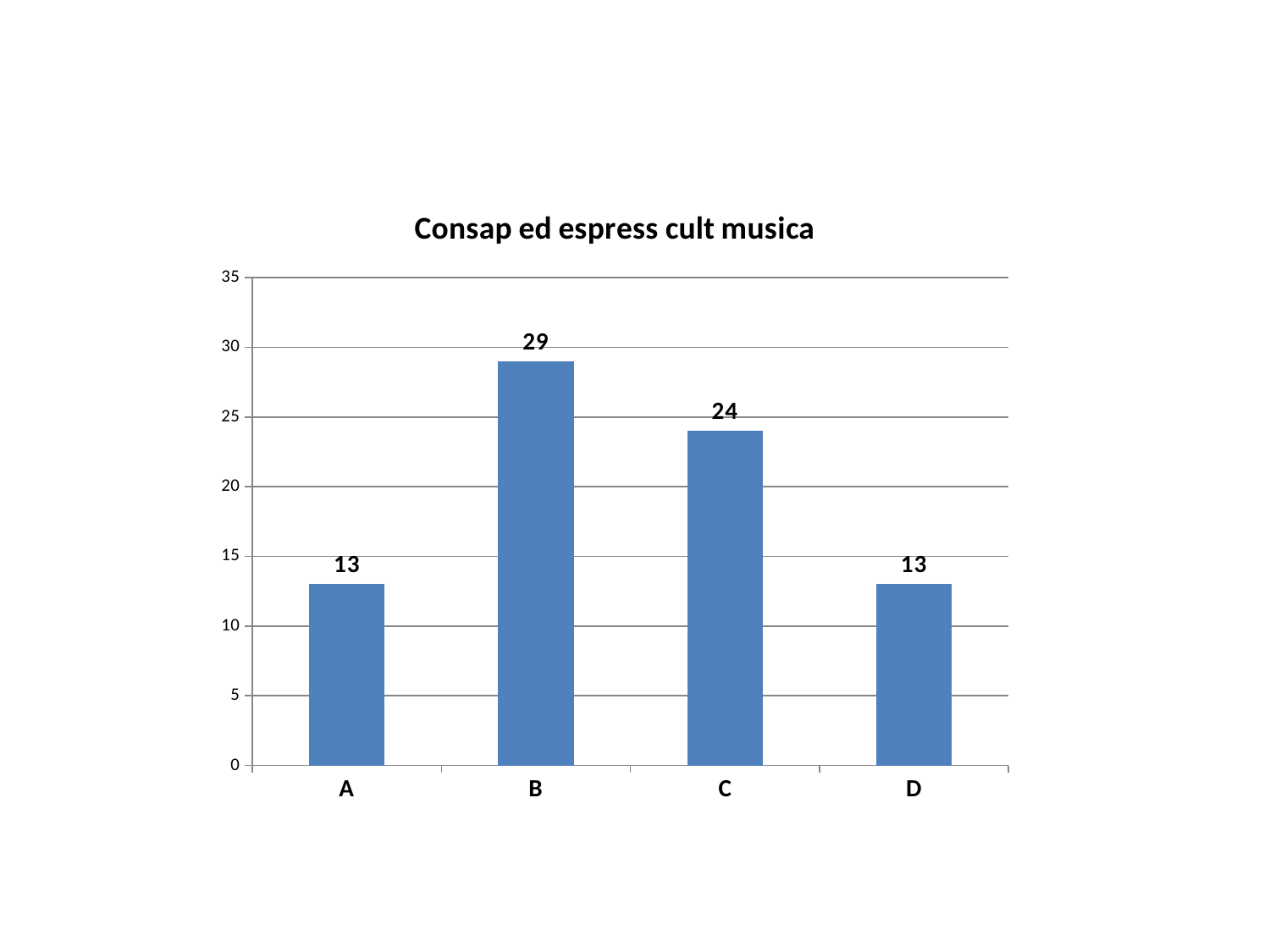
How many categories are shown on the x axis? 4 Is the value for B greater or less than 25? greater What is the value for category C? 24 What is the difference between the values for B and A? 16 What is the title of the chart? Consap ed espress cult musica Which is larger, the value for C or the value for D? C What is the value for category D? 13 What is the difference between the values for B and C? 5 What kind of chart is shown on the slide? Bar chart What is the value for category A? 13 Which category has the highest value? B What is the value for category B? 29